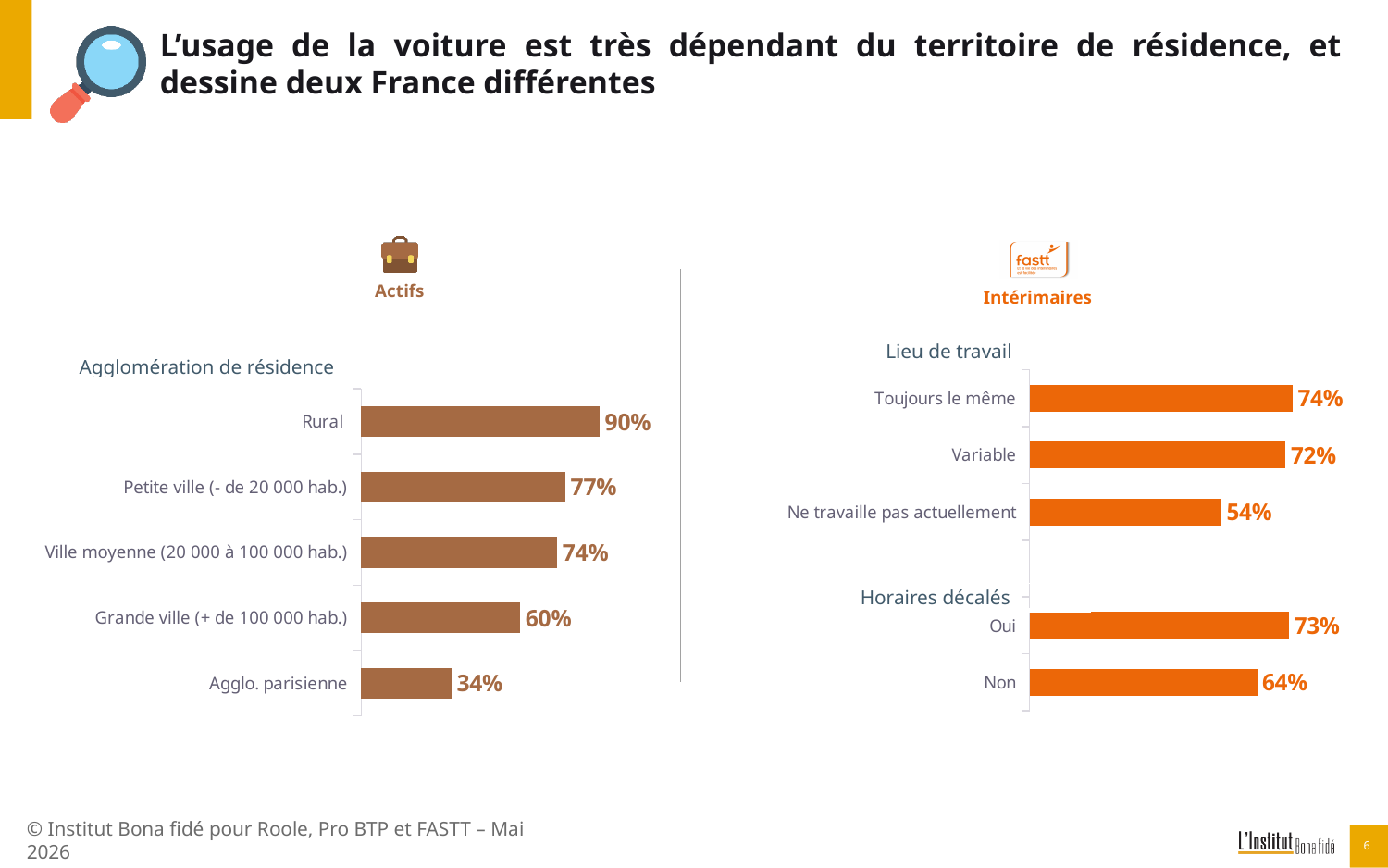
In the Intérimaires chart, what is the value for Oui under Horaires décalés? 73% In the Actifs chart (Agglomération de résidence), how many categories are shown? 5 In the Actifs chart (Agglomération de résidence), what is the difference between the values for Rural and Agglo. parisienne? 56 percentage points In the Intérimaires chart, which is larger: the value for Toujours le même or the value for Variable? Toujours le même In the Actifs chart (Agglomération de résidence), which category has the lowest value? Agglo. parisienne In the Actifs chart (Agglomération de résidence), which category has the highest value? Rural In the Actifs chart (Agglomération de résidence), what is the value for Rural? 90% In the Actifs chart (Agglomération de résidence), what is the value for Agglo. parisienne? 34% What type of chart is used on the left side of the slide for Actifs? Bar chart In the Intérimaires chart, what is the difference between the values for Oui and Non under Horaires décalés? 9 percentage points In the Intérimaires chart, what is the value for Ne travaille pas actuellement under Lieu de travail? 54% What colour are the bars in the Intérimaires chart on the right? Orange